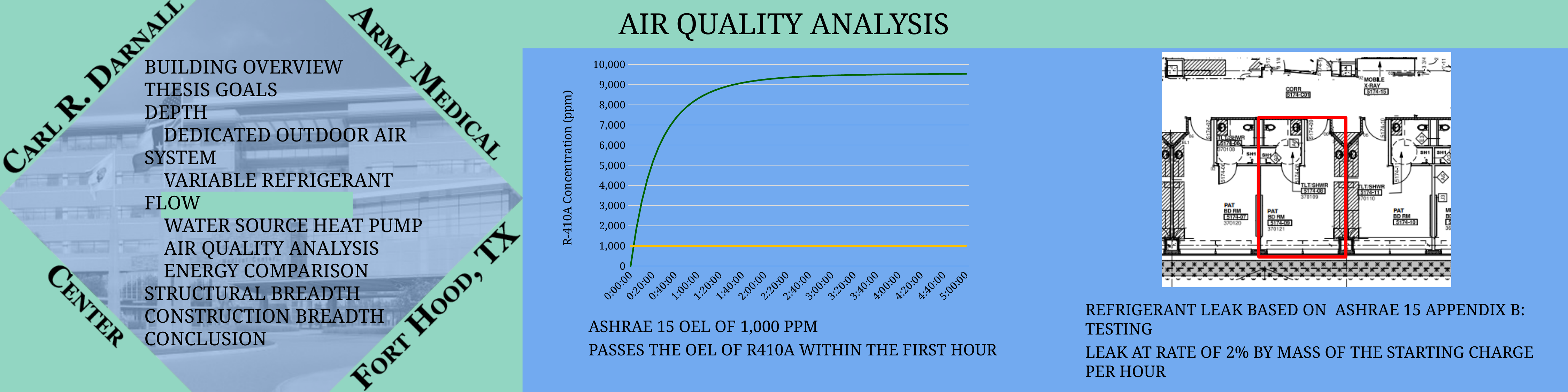
What kind of chart is shown on the slide? line chart Does the green line rise or fall as time increases along the x axis? rise Is the value of the green line at 1:00:00 greater or less than 8,000? greater How many time labels are shown along the x axis of the chart? 16 Which line is higher at 4:00:00, the green line or the yellow line? green line Is the value of the green line at 5:00:00 greater or less than 9,000? greater Is the value of the green line at 3:00:00 greater or less than 10,000? less How many lines are plotted on the chart? 2 At what concentration is the flat yellow line drawn on the chart? 1,000 What is the label on the vertical axis of the chart? R-410A Concentration (ppm) What is the highest value shown on the vertical axis of the chart? 10,000